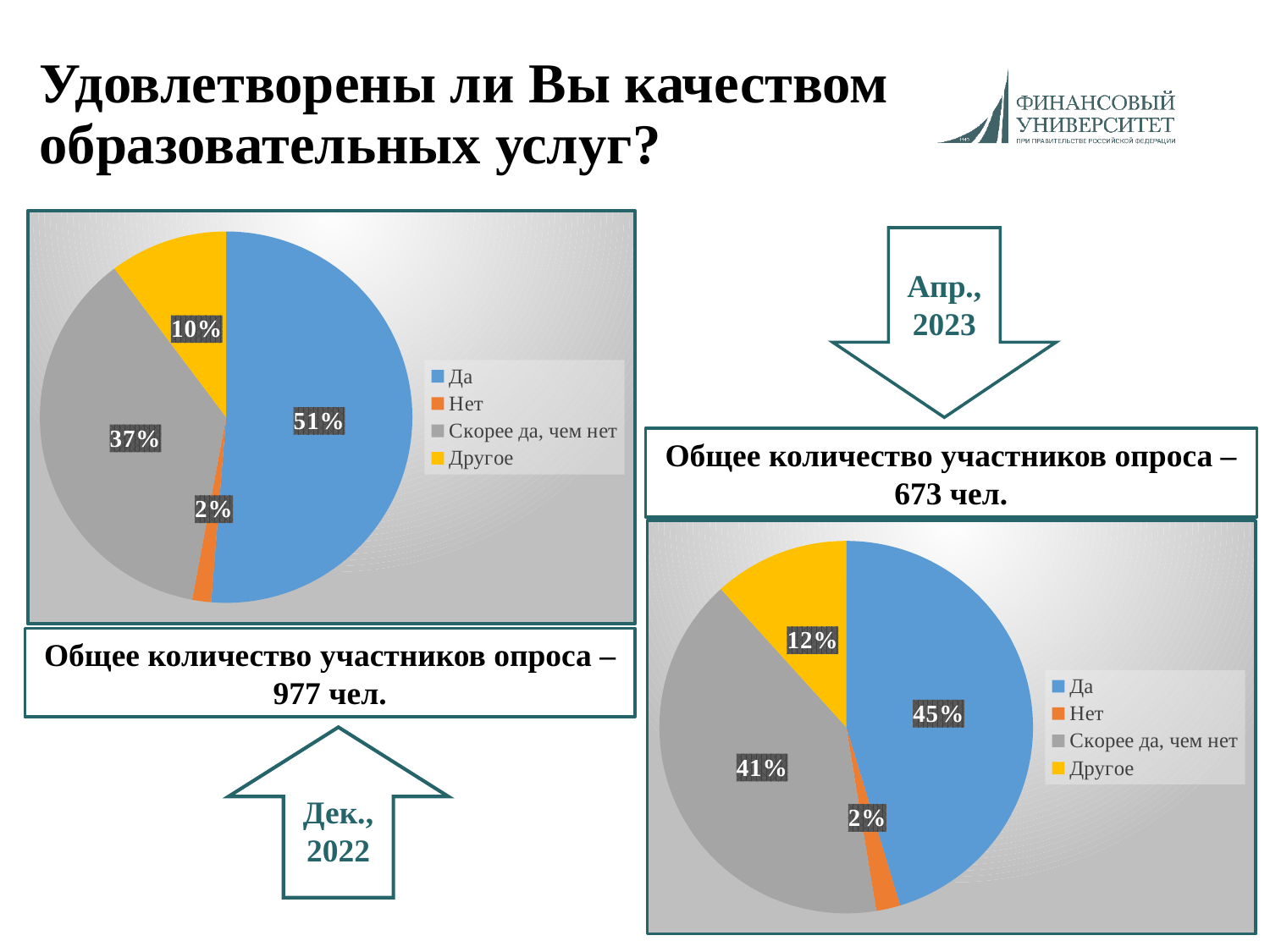
In the right pie chart (Апр., 2023), what share is labelled for "Другое"? 12% In the right pie chart (Апр., 2023), which is larger: the "Да" slice or the "Скорее да, чем нет" slice? Да In the left pie chart (Дек., 2022), which category has the largest slice? Да What type of chart is used on the right side of the slide (Апр., 2023)? Pie chart How many slices does the left pie chart (Дек., 2022) have? 4 Which colour represents "Другое" in the legend of the right pie chart (Апр., 2023)? Yellow In the left pie chart (Дек., 2022), what share is labelled for "Нет"? 2% In the right pie chart (Апр., 2023), which category has the smallest slice? Нет In the left pie chart (Дек., 2022), what share is labelled for "Да"? 51% In the left pie chart (Дек., 2022), what is the combined share of "Да" and "Скорее да, чем нет"? 88% In the right pie chart (Апр., 2023), what share is labelled for "Скорее да, чем нет"? 41% What is the difference between the "Да" share in the left pie chart (Дек., 2022) and the "Да" share in the right pie chart (Апр., 2023)? 6%